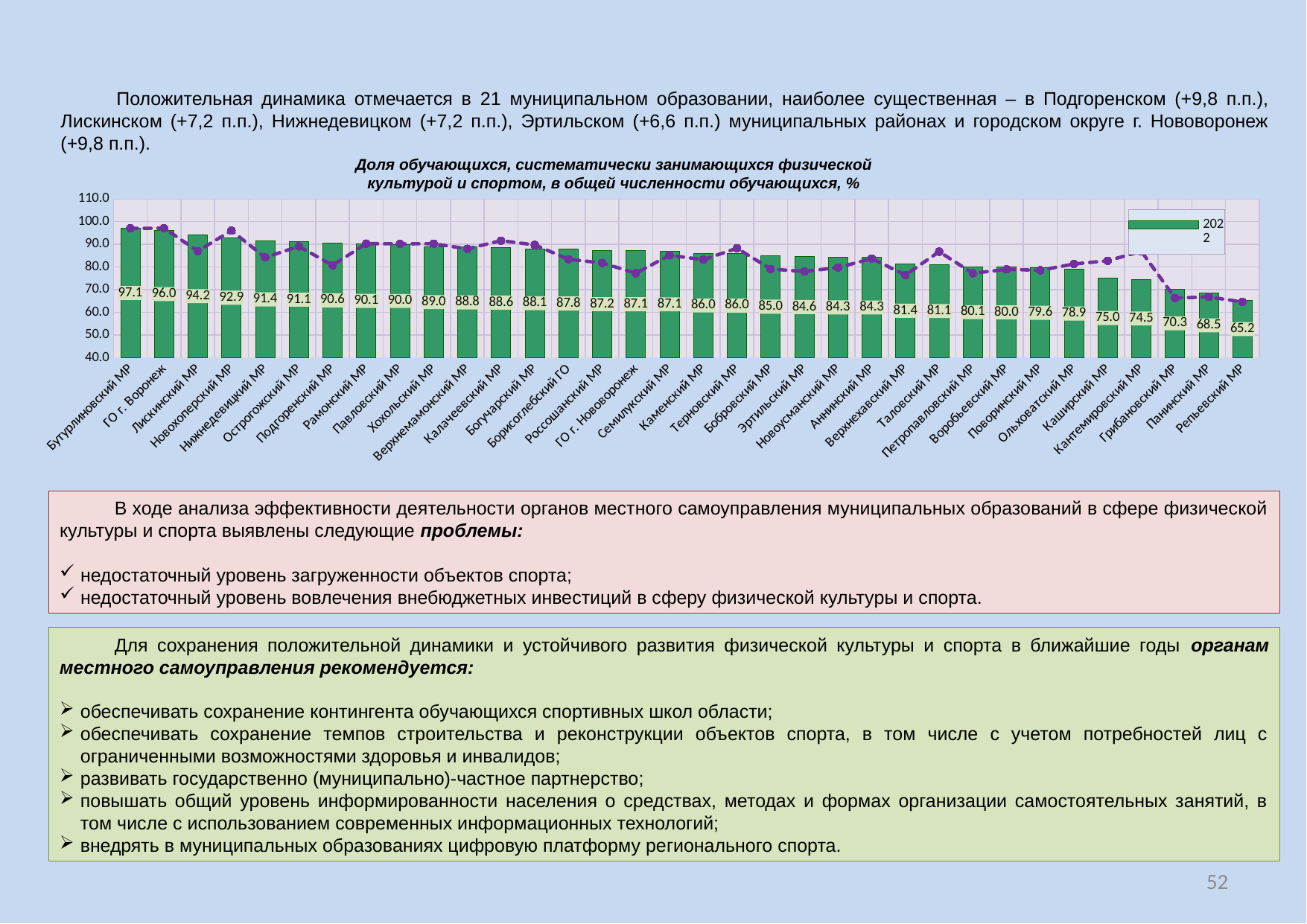
What is the value for Репьевский МР in the chart? 65.2 What is the difference between the values for Лискинский МР and Эртильский МР? 9.6 What is the difference between the values for Бутурлиновский МР and Репьевский МР? 31.9 What is the value for Подгоренский МР in the chart? 90.6 What is the value for Бутурлиновский МР in the chart? 97.1 Do the bar values rise or fall from left to right along the x axis? fall Is the value for Панинский МР greater or less than 70.0? less What kind of chart is shown on the slide? combination bar and line chart Which category has the highest bar in the chart? Бутурлиновский МР Which has a larger value, Каширский МР or Грибановский МР? Каширский МР What is the value for ГО г. Нововоронеж in the chart? 87.1 Which category has the lowest bar in the chart? Репьевский МР